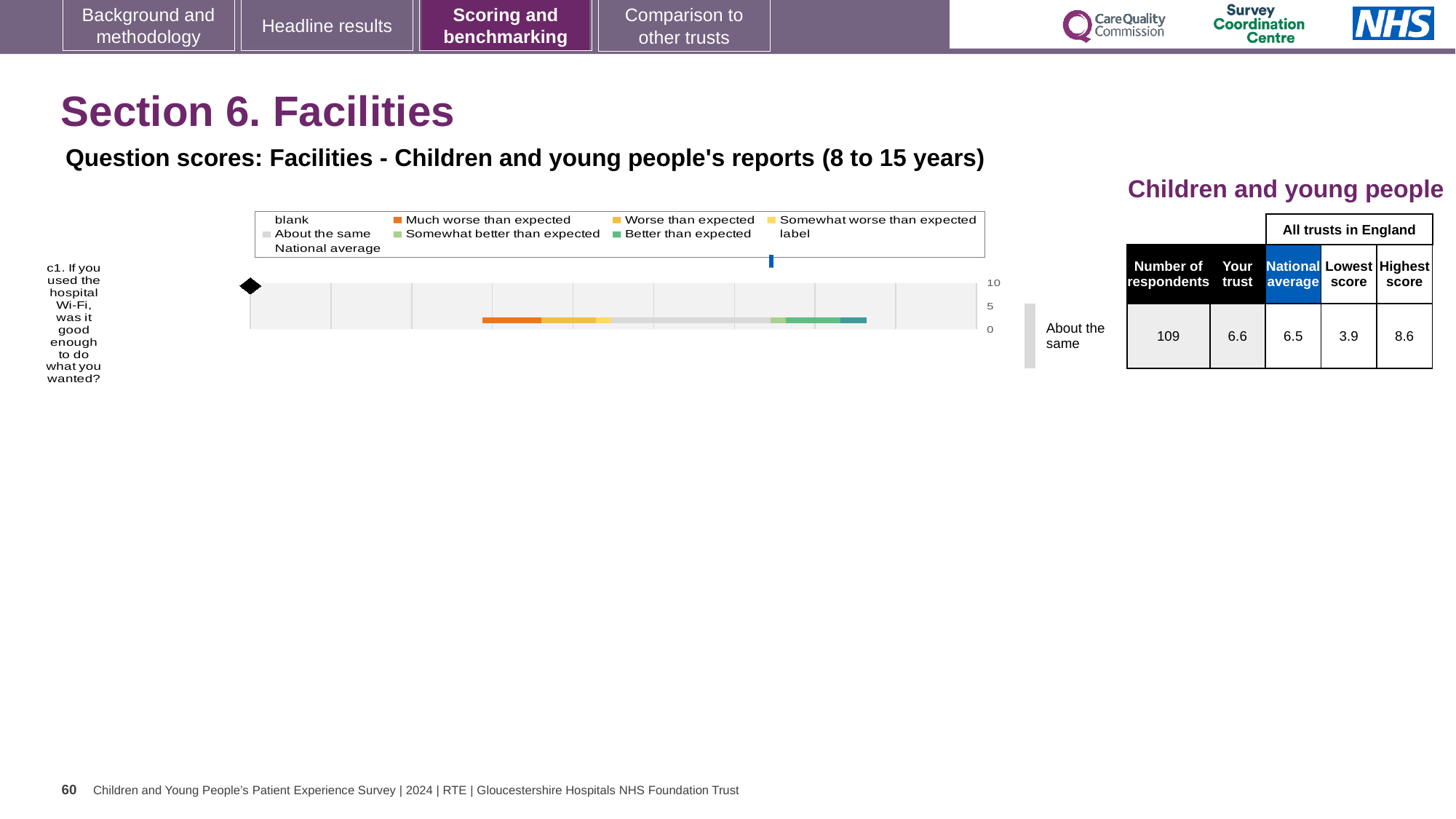
Is the trust's score for question c1 higher or lower than the national average? higher What kind of chart is used to show the question score for c1 on this slide? bar chart What is the lowest score among all trusts in England for question c1? 3.9 Which question is plotted in the chart on this slide? c1. If you used the hospital Wi-Fi, was it good enough to do what you wanted? What is the national average score for question c1 (hospital Wi-Fi)? 6.5 How is the trust's result for question c1 categorised relative to expectations? About the same How many respondents answered question c1 (hospital Wi-Fi)? 109 What is the highest score among all trusts in England for question c1? 8.6 What is the difference between the highest and lowest scores for question c1 across all trusts in England? 4.7 What is the trust's score for question c1 (hospital Wi-Fi)? 6.6 How many survey questions are plotted in the chart on this slide? 1 What is the maximum value shown on the chart's score axis? 10